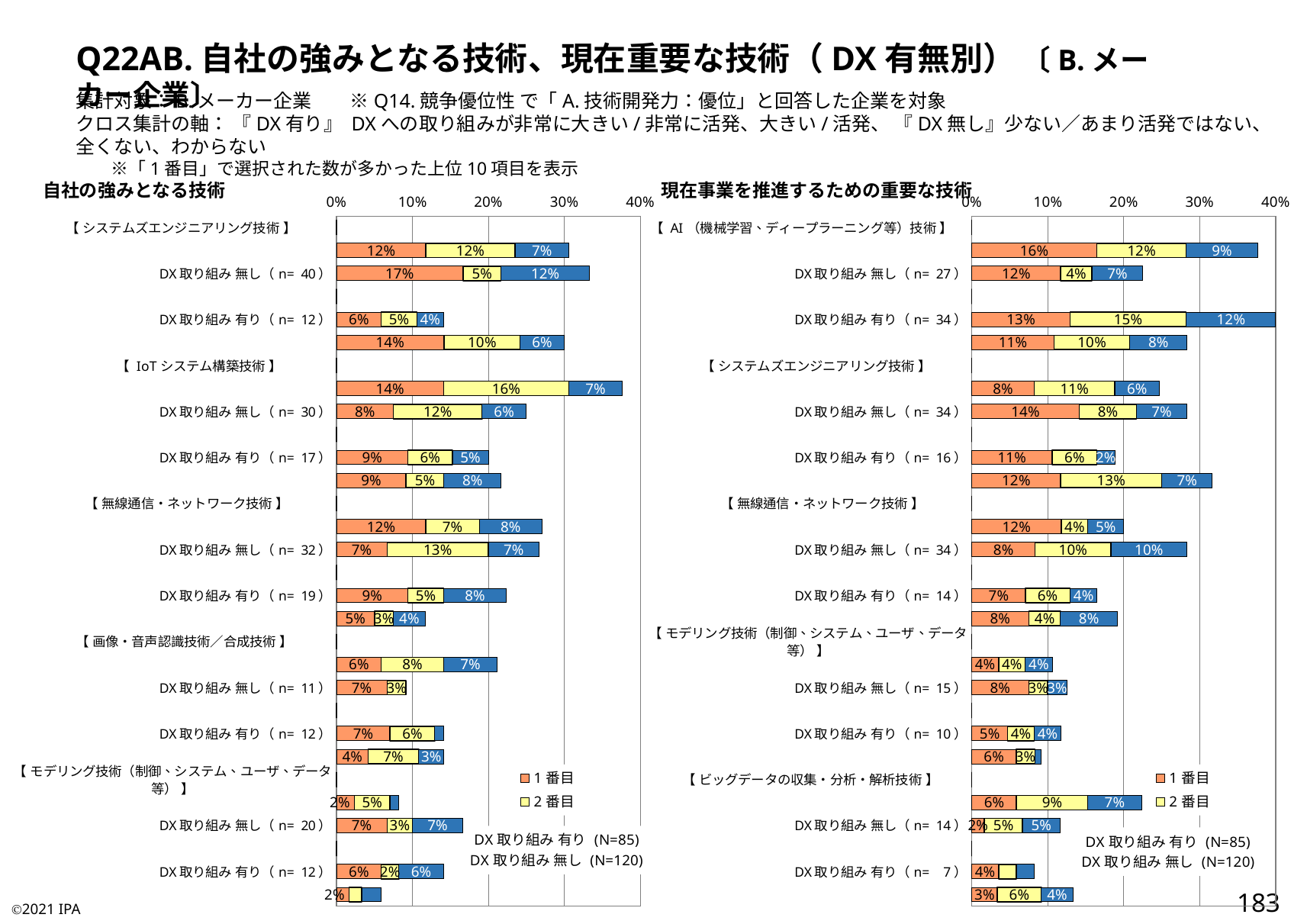
In the left chart (自社の強みとなる技術), what is the total of the stacked bar for the DX取り組み無し (n=40) row? 34% In the right chart (現在事業を推進するための重要な技術), what is the 1番目 value for the DX取り組み無し (n=27) row? 12% In the right chart (現在事業を推進するための重要な技術), what is the 2番目 value for the DX取り組み有り (n=34) row under AI技術? 15% How many series entries does the legend of the left chart list? 2 In the right chart (現在事業を推進するための重要な技術), which is larger for the 1番目 series: the DX取り組み無し (n=34) row under システムズエンジニアリング技術 or the DX取り組み有り (n=16) row? DX取り組み無し (n=34) What kind of chart is the left chart titled 自社の強みとなる技術? Stacked bar chart In the left chart (自社の強みとなる技術), what is the 1番目 value for the DX取り組み無し (n=30) row? 8% In the right chart (現在事業を推進するための重要な技術), what is the difference between the 1番目 values of the DX取り組み無し (n=34) row (14%) and the DX取り組み有り (n=16) row (11%) under システムズエンジニアリング技術? 3% In the right chart (現在事業を推進するための重要な技術), what is the total of the stacked bar for the DX取り組み有り (n=34) row under AI技術? 40% In the left chart (自社の強みとなる技術), what is the 2番目 value for the DX取り組み有り (n=12) row under システムズエンジニアリング技術? 5% What is the maximum value shown on the horizontal axis of the right chart? 40% In the left chart (自社の強みとなる技術), what is the 1番目 value for the DX取り組み無し (n=40) row? 17%